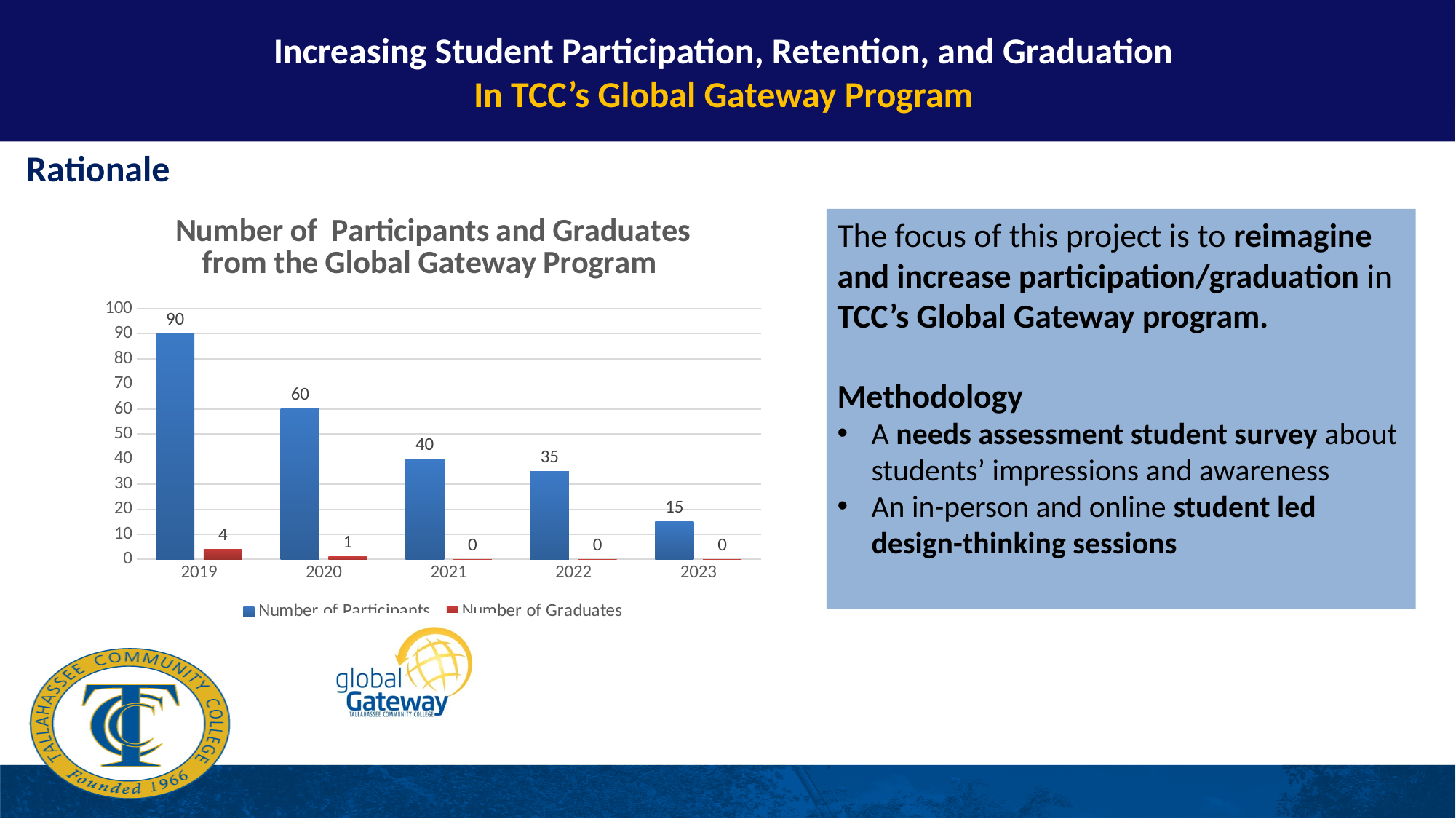
Does the number of participants rise or fall from 2019 to 2023? fall What is the difference between the number of participants in 2019 and 2020? 30 Which is larger, the number of participants in 2021 or in 2022? 2021 Which year has the highest number of participants? 2019 Which year has the lowest number of participants? 2023 How many years are shown on the x axis? 5 What is the number of participants in 2023? 15 Is the number of participants in 2022 greater or less than 50? less How many series does the legend list? 2 What kind of chart is shown? bar chart What is the number of participants in 2019? 90 What is the number of graduates in 2020? 1